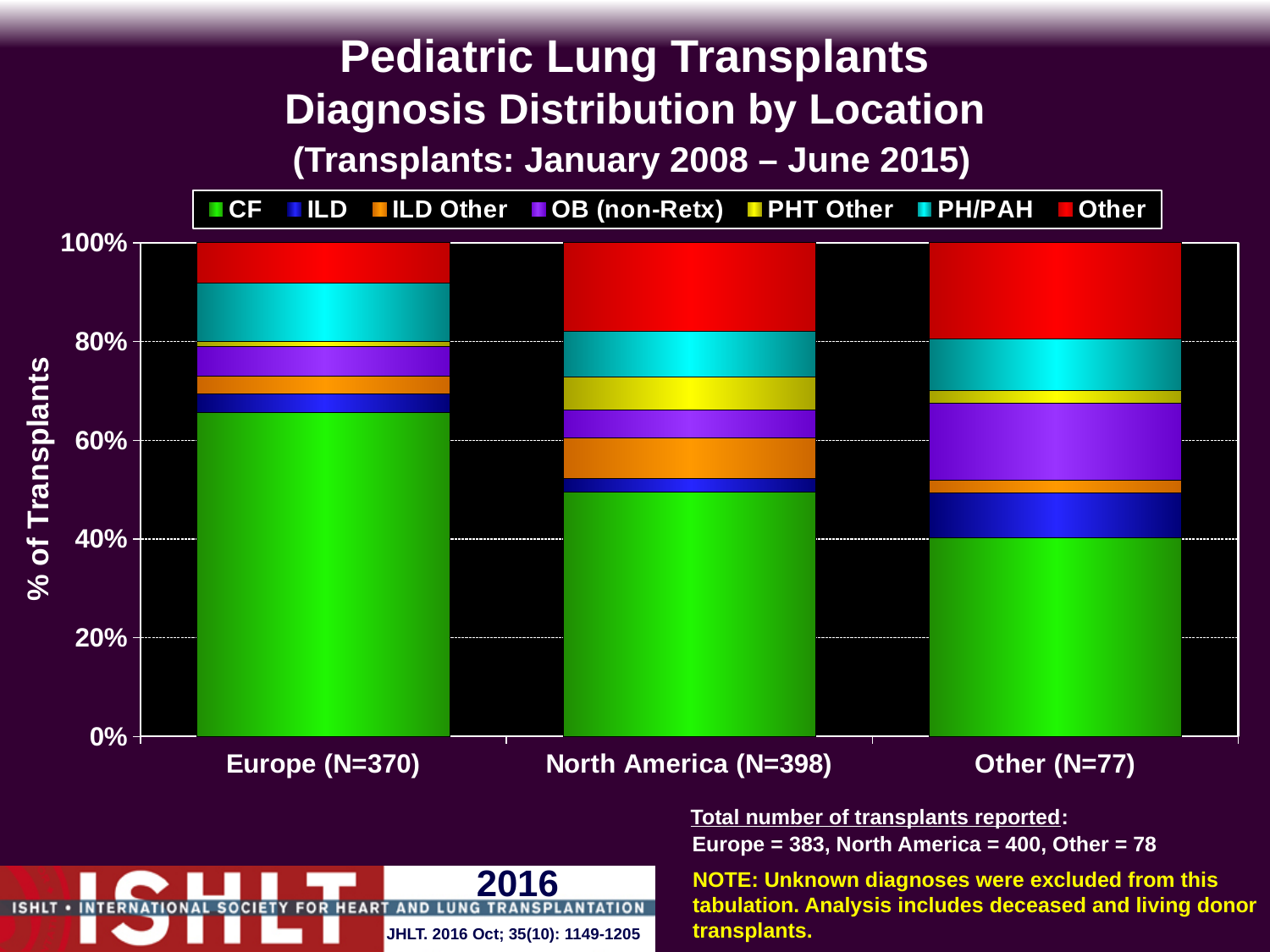
Which location has the larger 'Other' diagnosis share: Europe or North America? North America (N=398) How many diagnosis series does the legend list? 7 Is the CF percentage for North America greater or less than 40%? greater Which location has the lowest percentage of CF transplants? Other (N=77) Which location has the highest percentage of CF transplants? Europe (N=370) What is the N value shown for North America on the x axis? N=398 How many location categories are plotted on the x axis? 3 Which location has the larger ILD share: Europe or Other? Other (N=77) Is the CF percentage for North America greater or less than 60%? less Is the CF percentage for Europe greater or less than 60%? greater What kind of chart is shown on the slide? Stacked bar chart Which location has the larger OB (non-Retx) share: Europe or Other? Other (N=77)